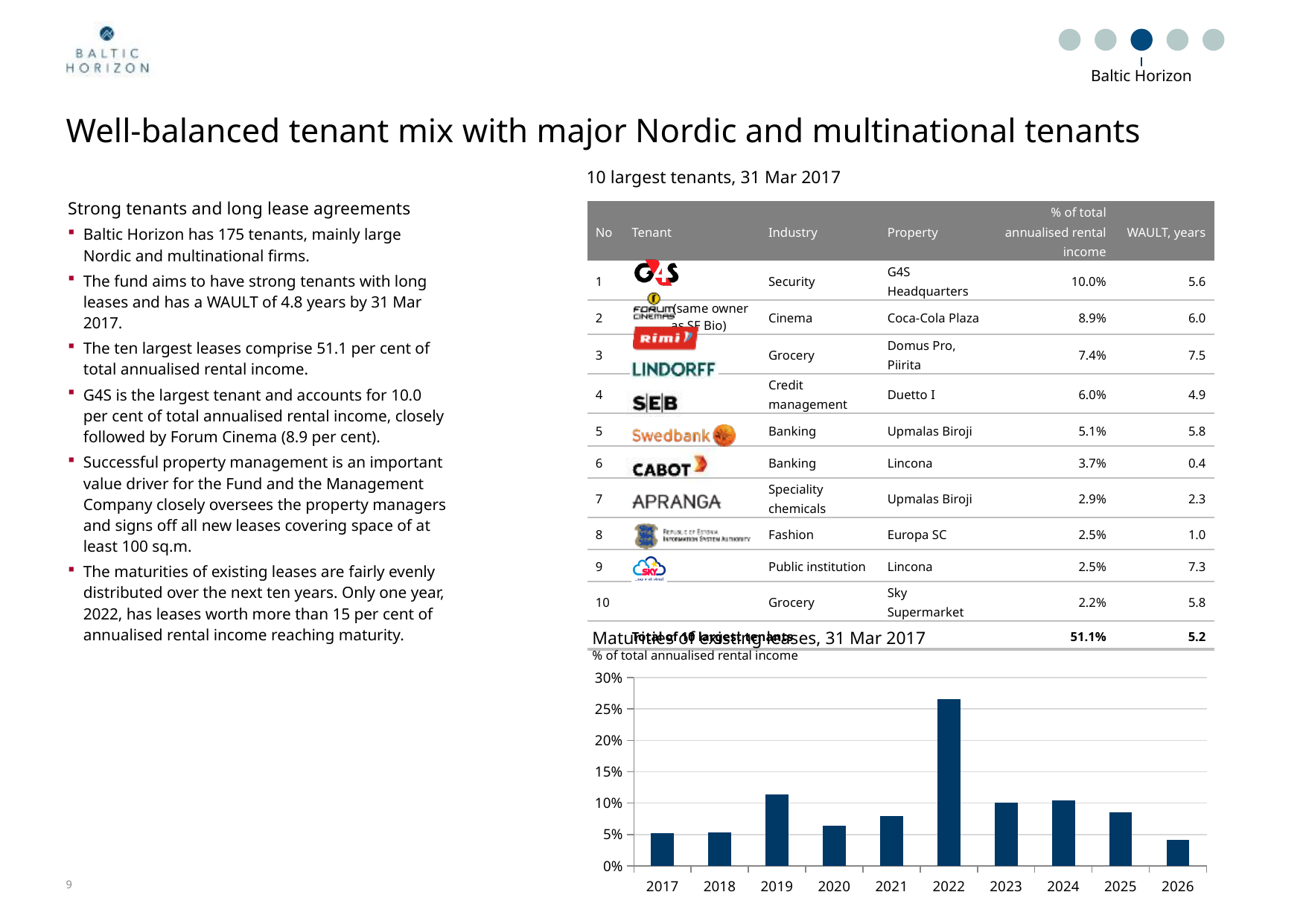
In the 'Maturities of existing leases' chart, which is larger, the value for 2022 or the value for 2023? 2022 In the 'Maturities of existing leases' chart, is the value for 2026 greater or less than 5%? less In the 'Maturities of existing leases' chart, which is larger, the value for 2021 or the value for 2026? 2021 In the 'Maturities of existing leases' chart, which is larger, the value for 2019 or the value for 2020? 2019 In the 'Maturities of existing leases' chart, is the value for 2021 greater or less than 10%? less In the 'Maturities of existing leases' chart, how many years are shown on the x axis? 10 In the 'Maturities of existing leases' chart, is the value for 2019 greater or less than 10%? greater What kind of chart is the 'Maturities of existing leases, 31 Mar 2017' chart? bar chart In the 'Maturities of existing leases' chart, which year has the highest share of annualised rental income maturing? 2022 What does the y axis of the 'Maturities of existing leases' chart measure, according to its subtitle? % of total annualised rental income